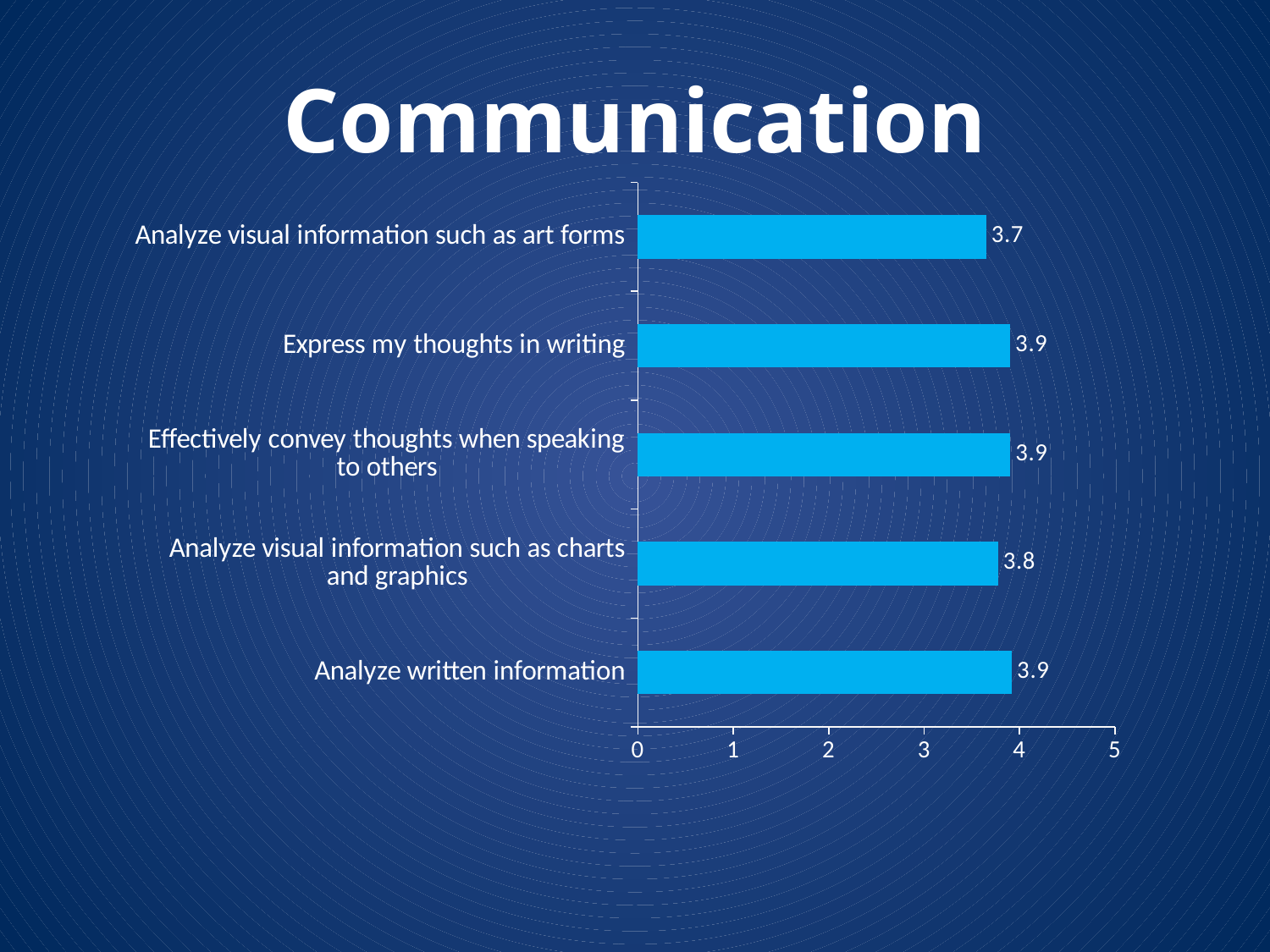
Which category has the lowest value? Analyze visual information such as art forms What is the value for "Analyze visual information such as art forms"? 3.7 What is the difference between the values for "Express my thoughts in writing" and "Analyze visual information such as art forms"? 0.2 What is the value for "Analyze written information"? 3.9 What is the value for "Effectively convey thoughts when speaking to others"? 3.9 Which is larger: the value for "Analyze written information" or the value for "Analyze visual information such as charts and graphics"? Analyze written information Is the value for "Analyze visual information such as art forms" greater or less than 4? less What is the value for "Express my thoughts in writing"? 3.9 What kind of chart is shown on the slide? bar chart What is the value for "Analyze visual information such as charts and graphics"? 3.8 How many categories are shown in the chart? 5 What is the title of the slide? Communication